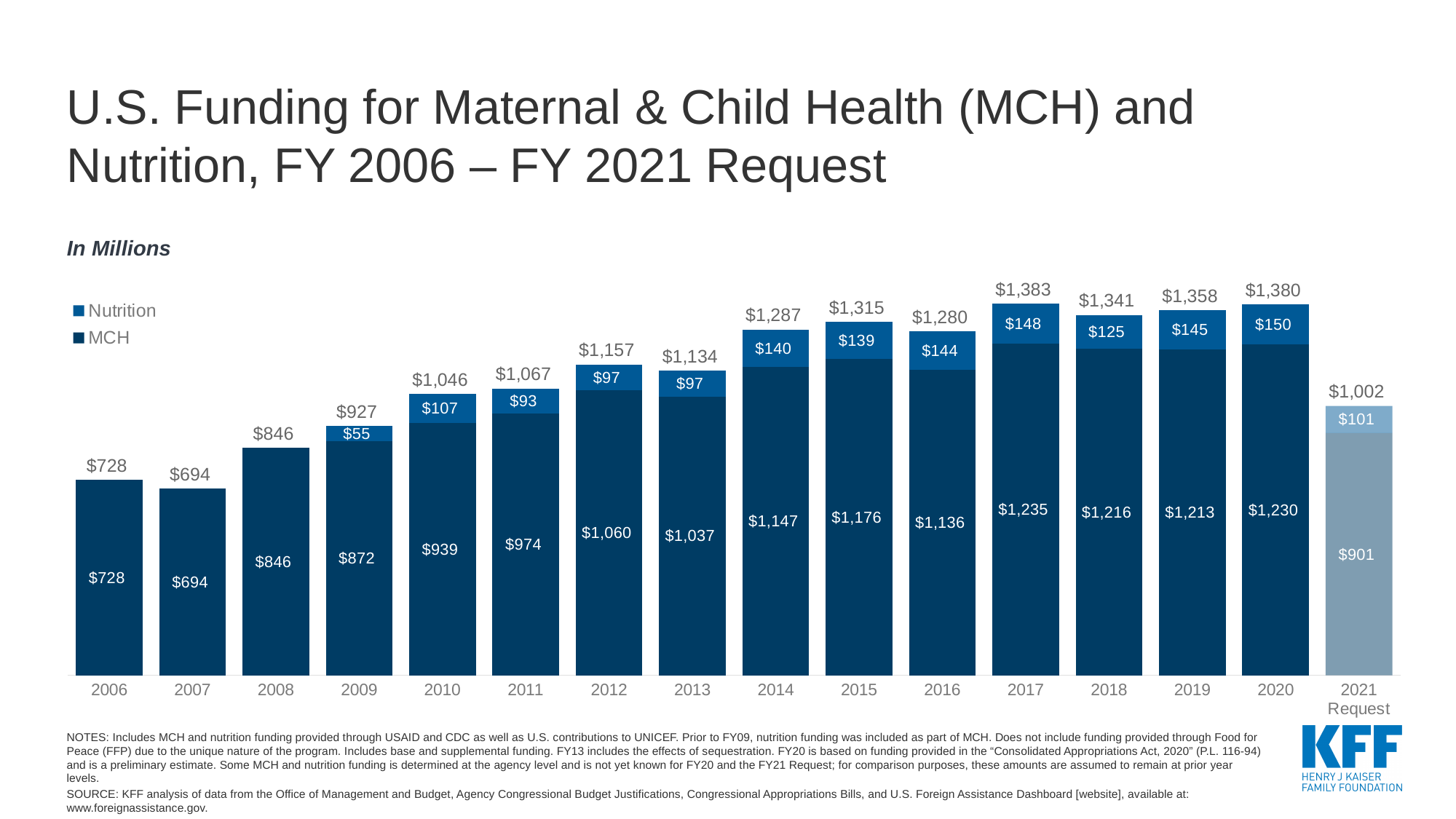
How many years (categories) are shown on the x axis? 16 What kind of chart is shown on the slide? Stacked bar chart Which year has the lowest total funding? 2007 What is the total funding shown for 2017? $1,383 What is the Nutrition value for 2009? $55 Which is larger, the MCH value for 2015 or the MCH value for 2016? 2015 What is the MCH value for the 2021 Request? $901 What is the MCH value for 2014? $1,147 What is the difference between the total funding for 2020 and for 2006? $652 Which year has the highest total funding? 2017 Which year has the highest Nutrition value? 2020 How many series does the legend list? 2